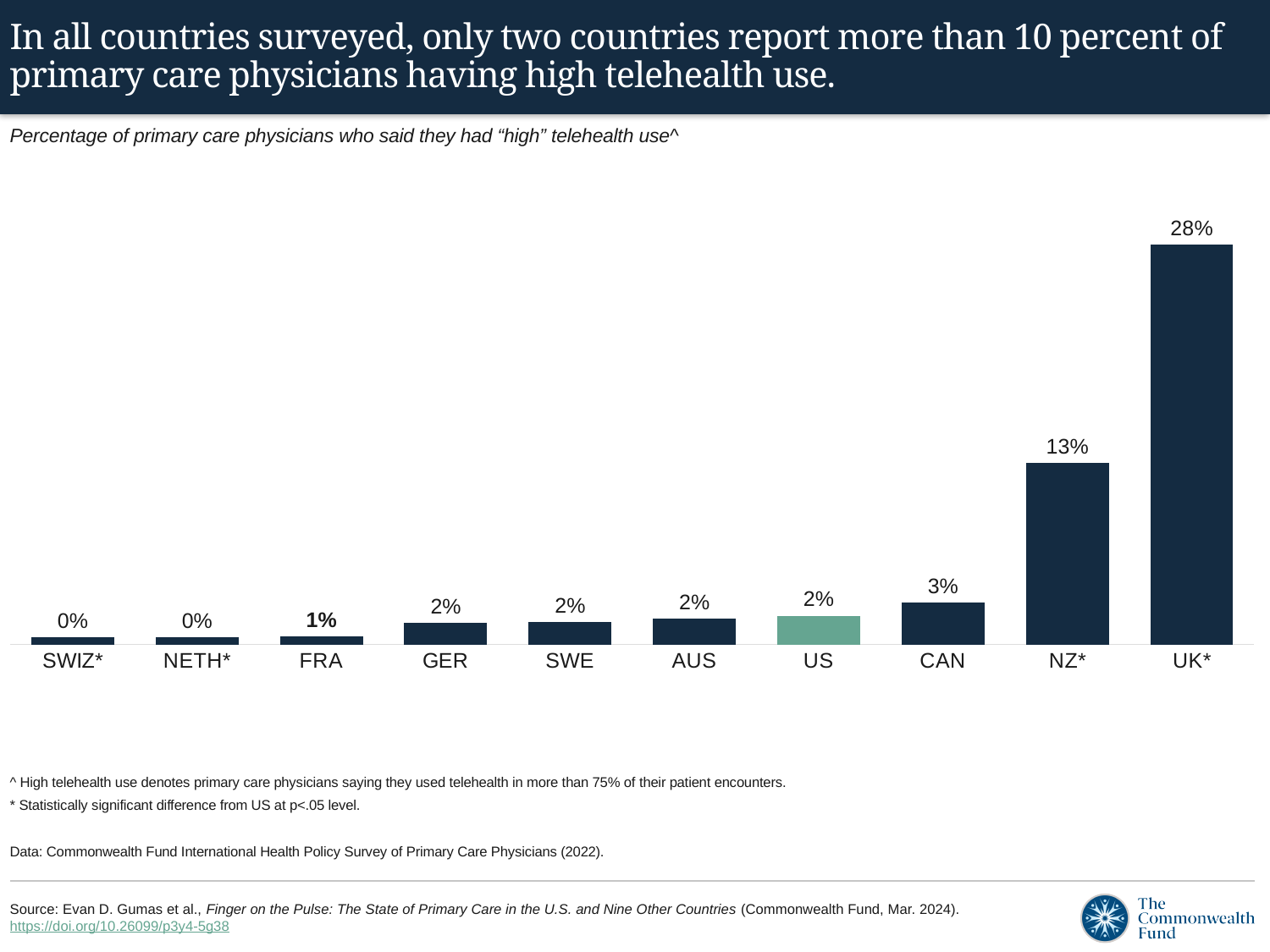
Which is larger, the value for CAN or the value for GER? CAN What is the difference between the values for NZ* and CAN? 10% What is the value for the US? 2% How many countries are shown on the chart? 10 What is the value for FRA? 1% Which country's bar is shown in a different colour (green) from the others? US What is the value for UK*? 28% What is the value for CAN? 3% Which country has the highest value? UK* What is the difference between the values for UK* and NZ*? 15% What is the value for NZ*? 13% What kind of chart is shown on the slide? Bar chart